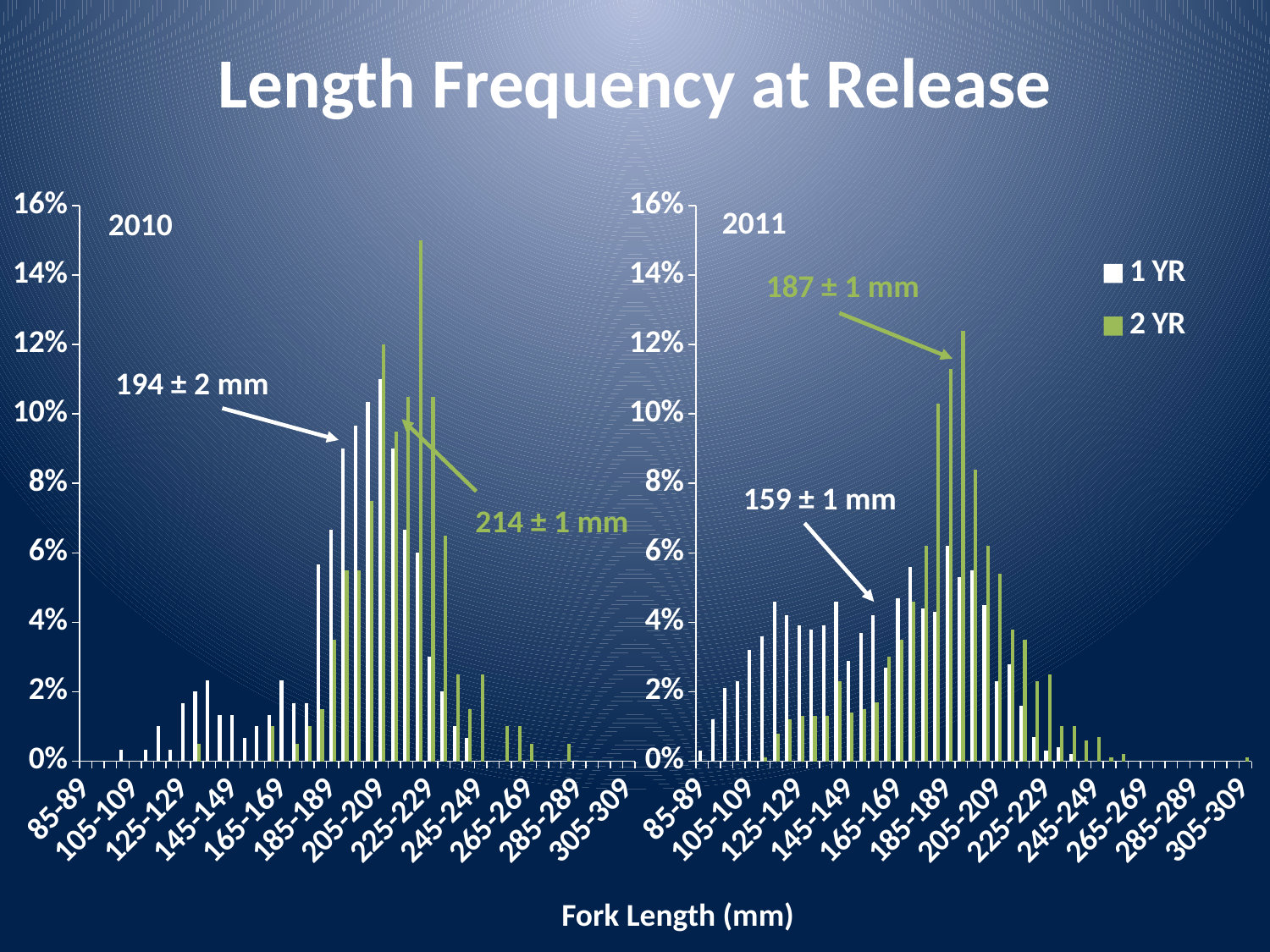
In the 2011 chart, is the tallest 1 YR bar greater or less than 8%? less What kind of chart is the 2010 chart? bar chart What is the title of the slide's charts? Length Frequency at Release What are the two series named in the legend? 1 YR and 2 YR In the 2010 chart, which series reaches the higher peak, 1 YR or 2 YR? 2 YR How many series does the legend list? 2 What mean length is annotated for the 2 YR series in the 2011 chart? 187 ± 1 mm In the 2011 chart, is the tallest 2 YR bar greater or less than 10%? greater What mean length is annotated for the 1 YR series in the 2010 chart? 194 ± 2 mm In the 2011 chart, which series reaches the higher peak, 1 YR or 2 YR? 2 YR In the 2010 chart, is the tallest 1 YR bar greater or less than 12%? less